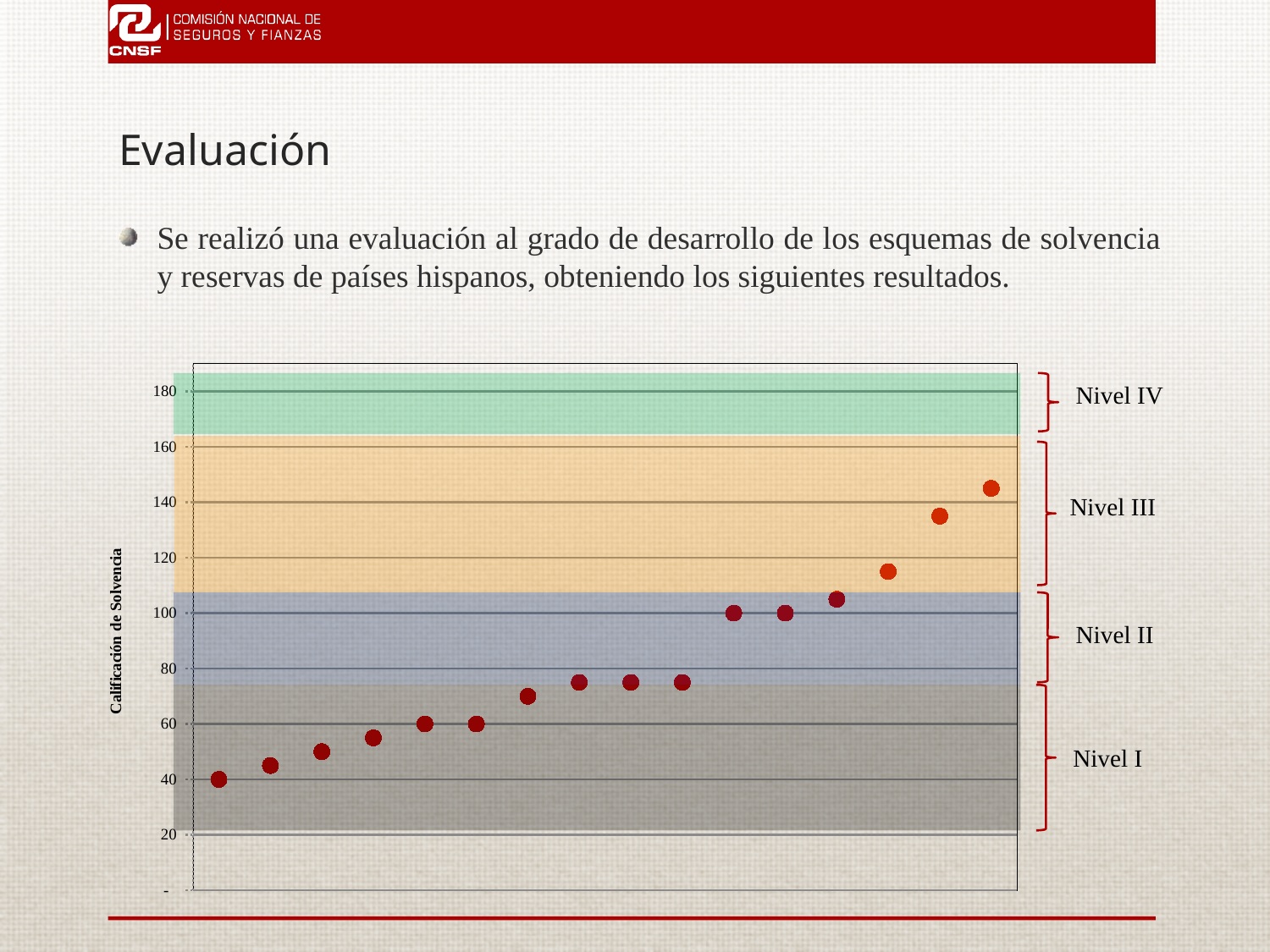
Is the value of the leftmost plotted point greater or less than 60? less How many plotted points fall within the Nivel IV band? 0 How many data points are plotted in the chart? 16 Is the value of the highest plotted point greater or less than 120? greater Which plotted point is higher, the leftmost point or the rightmost point? The rightmost point What is the label of the vertical axis of the chart? Calificación de Solvencia What is the highest tick value shown on the vertical axis? 180 What kind of chart is shown on the slide? Scatter chart Do the plotted values rise or fall from left to right along the x axis? Rise What is the value of the lowest plotted point in the chart? 40 How many 'Nivel' bands are marked on the right side of the chart? 4 Is the value of the rightmost plotted point greater or less than 160? less